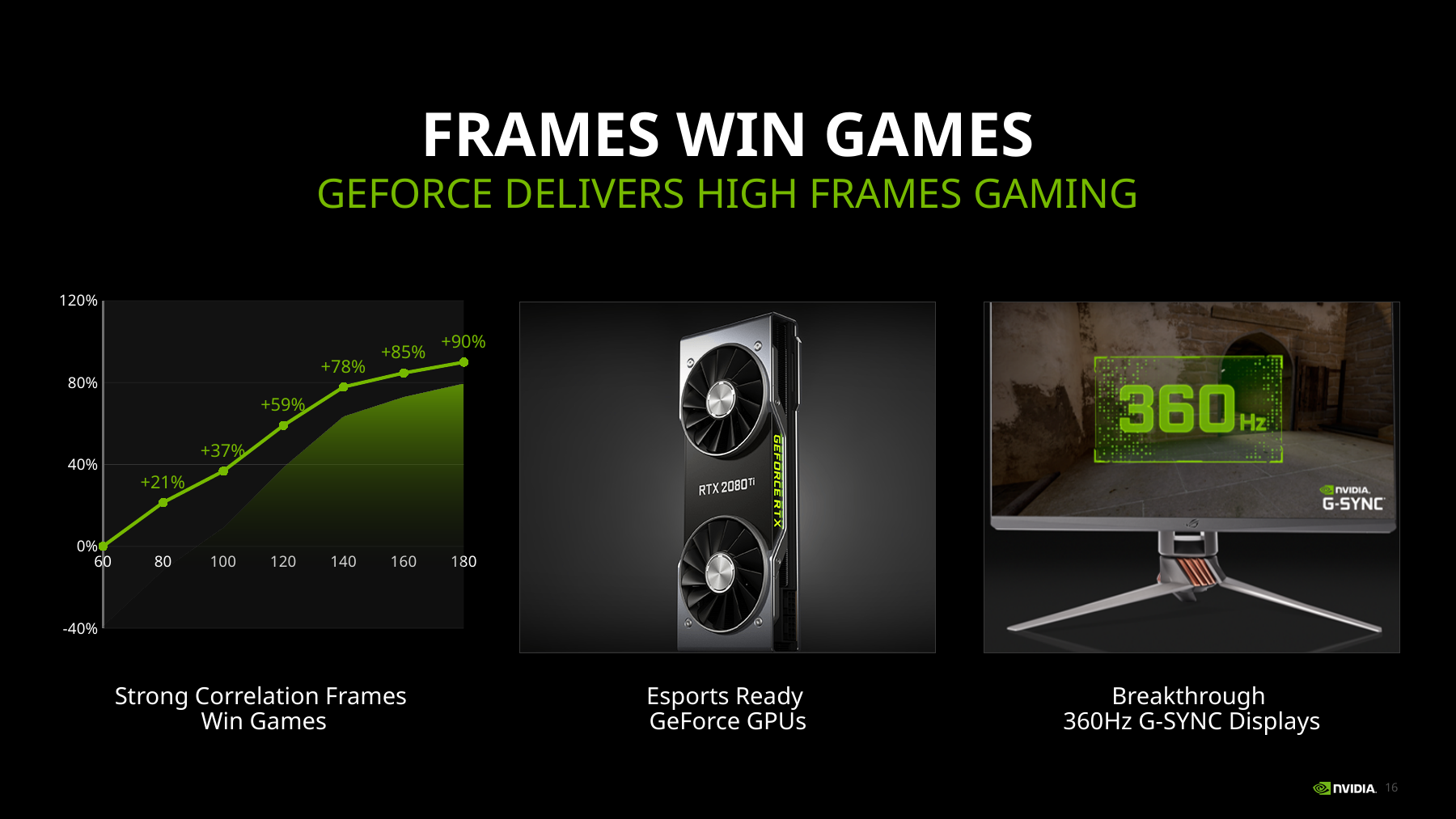
What is the caption below the line chart? Strong Correlation Frames Win Games In the line chart, at which x-axis value is the plotted value highest? 180 In the line chart, do the values rise or fall as the x axis increases from 60 to 180? rise In the line chart, what is the value at 140 on the x axis? +78% In the line chart, at which x-axis value is the plotted value lowest? 60 How many labelled x-axis ticks does the line chart have? 7 In the line chart, what is the value at 80 on the x axis? +21% In the line chart, what is the value at 180 on the x axis? +90% In the line chart, what is the value at 120 on the x axis? +59% In the line chart, what is the difference between the values at 160 and 100? 48% In the line chart, which is larger: the value at 100 or the value at 140? 140 What kind of chart is shown on the left of the slide? line chart